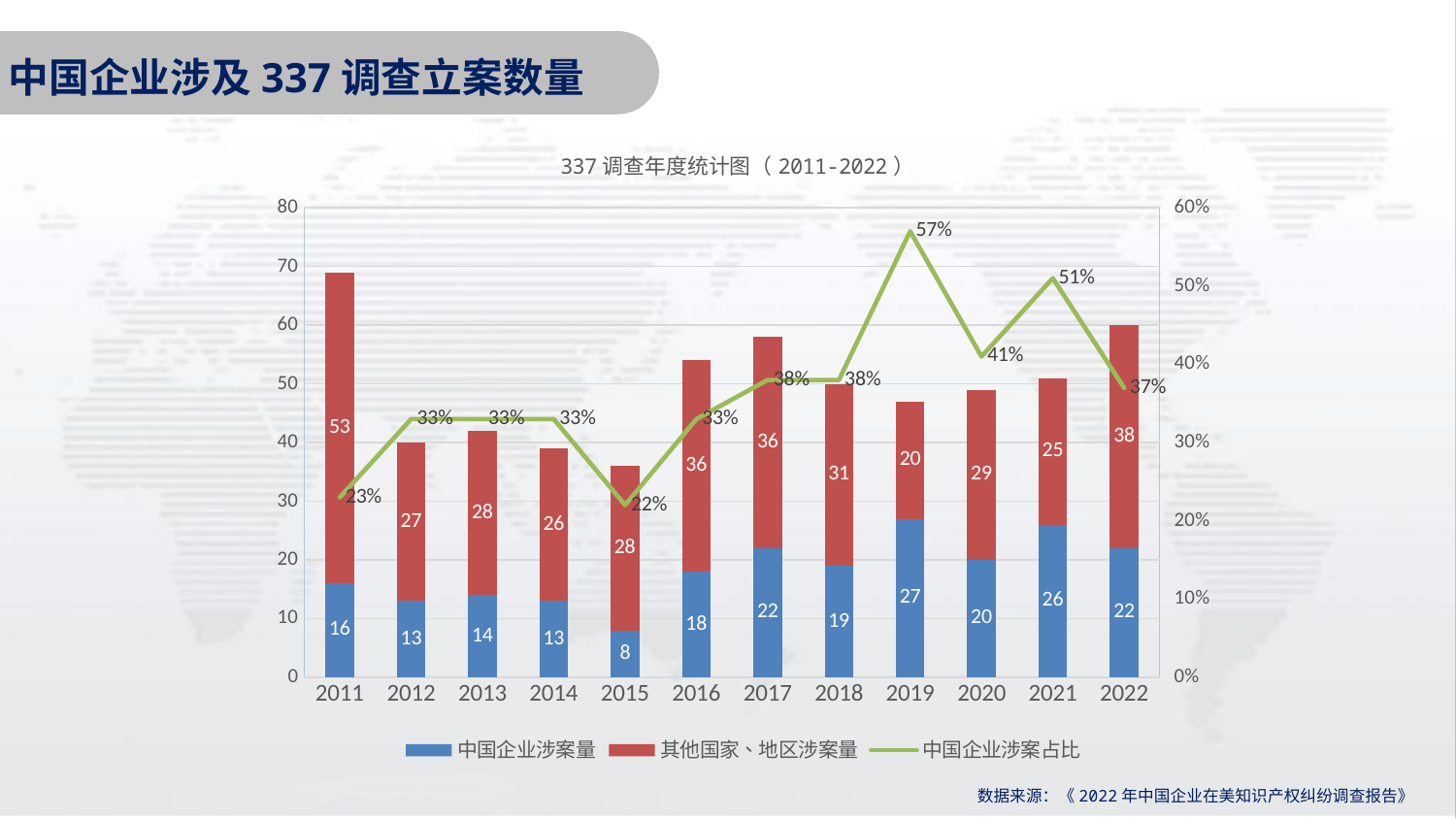
In which year is 中国企业涉案占比 highest? 2019 What is the title of the chart? 337 调查年度统计图（2011-2022） What is the value for 中国企业涉案量 in 2019? 27 Which is larger in 2019: 中国企业涉案量 or 其他国家、地区涉案量? 中国企业涉案量 What kind of chart is this? Combined stacked bar and line chart How many years are shown on the x axis? 12 How many series does the legend list? 3 What is the value for 其他国家、地区涉案量 in 2011? 53 What is the difference between 其他国家、地区涉案量 in 2022 and in 2021? 13 What is the 中国企业涉案占比 value for 2021? 51% What is the total of the stacked bar for 2011? 69 In which year is 中国企业涉案量 lowest? 2015